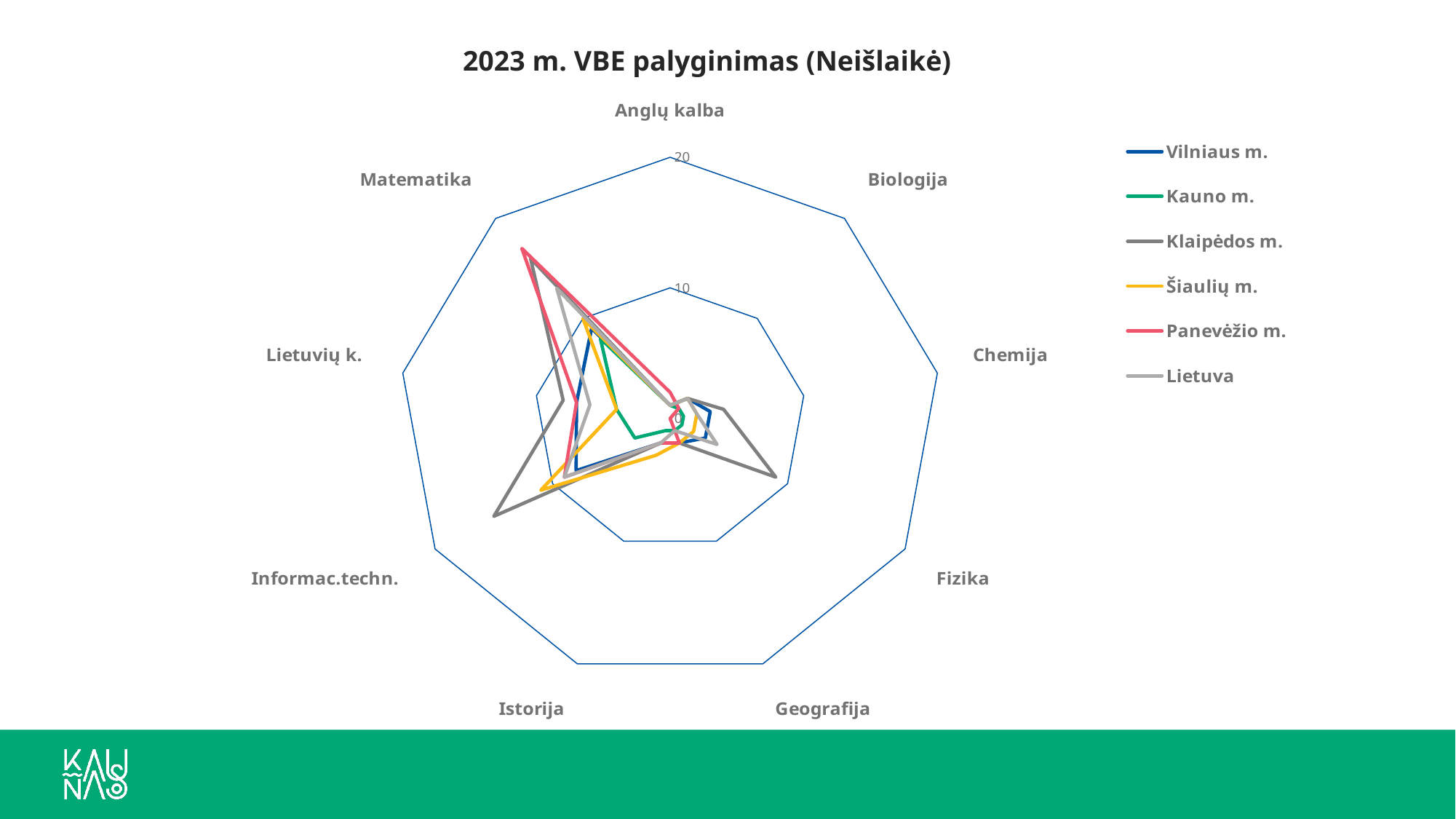
Which series has the highest value at Informac.techn.? Klaipėdos m. What is the title of the chart? 2023 m. VBE palyginimas (Neišlaikė) Is the value for Klaipėdos m. at Matematika greater or less than 10? greater Which series is plotted in red? Panevėžio m. Which series has the highest value at Matematika? Panevėžio m. What kind of chart is shown on the slide? radar chart How many series does the legend list? 6 How many subject categories are plotted around the radar chart? 9 Is the value for Kauno m. at Matematika greater or less than 10? less Is the value for Vilniaus m. at Anglų kalba greater or less than 10? less